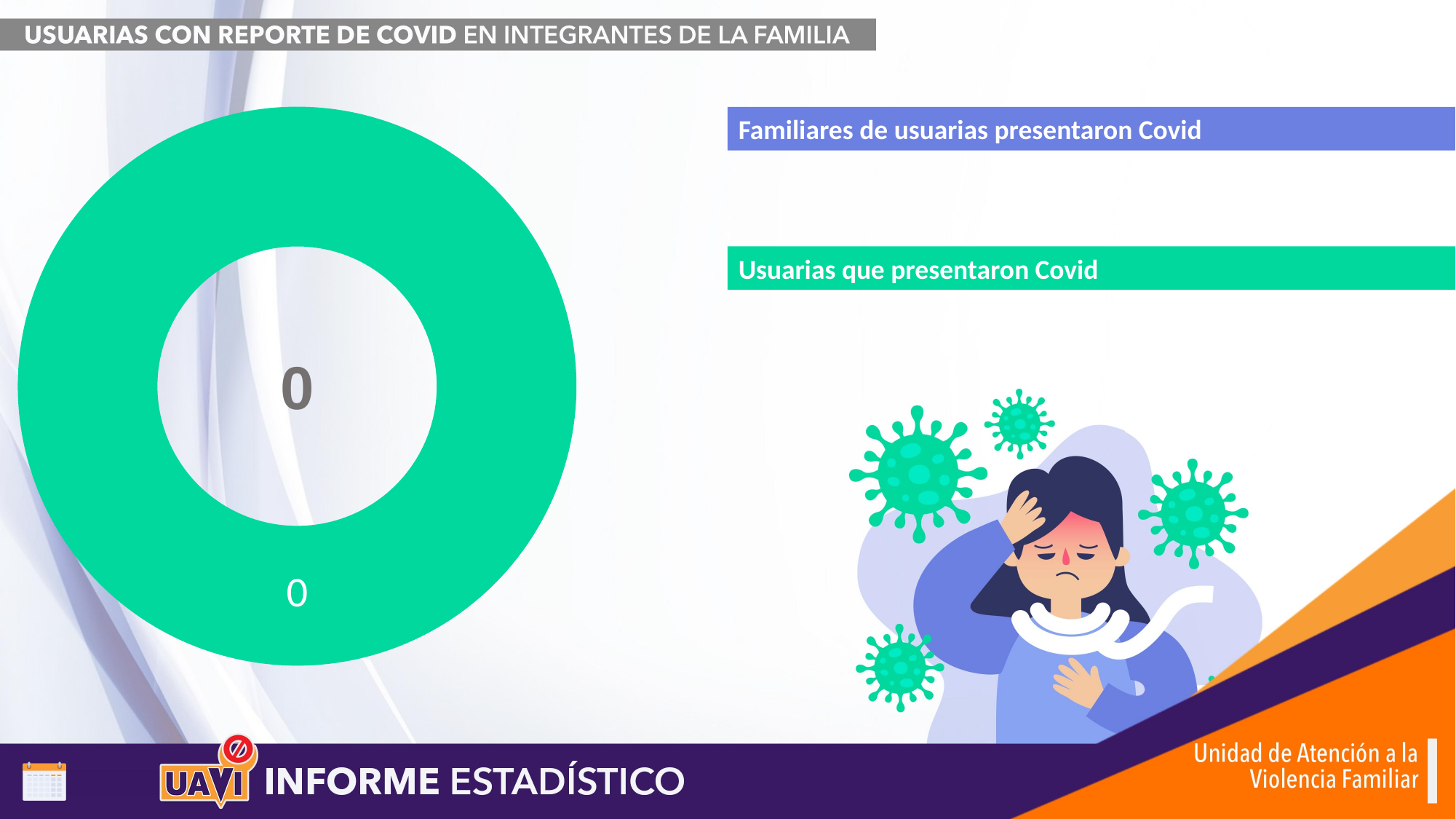
Which legend entry is shown in blue? Familiares de usuarias presentaron Covid What kind of chart is shown on the slide? Doughnut chart Which legend entry is shown in green? Usuarias que presentaron Covid How many entries does the legend of the chart list? 2 What number is displayed in the centre of the doughnut chart? 0 What value is printed as the data label on the green ring of the doughnut chart? 0